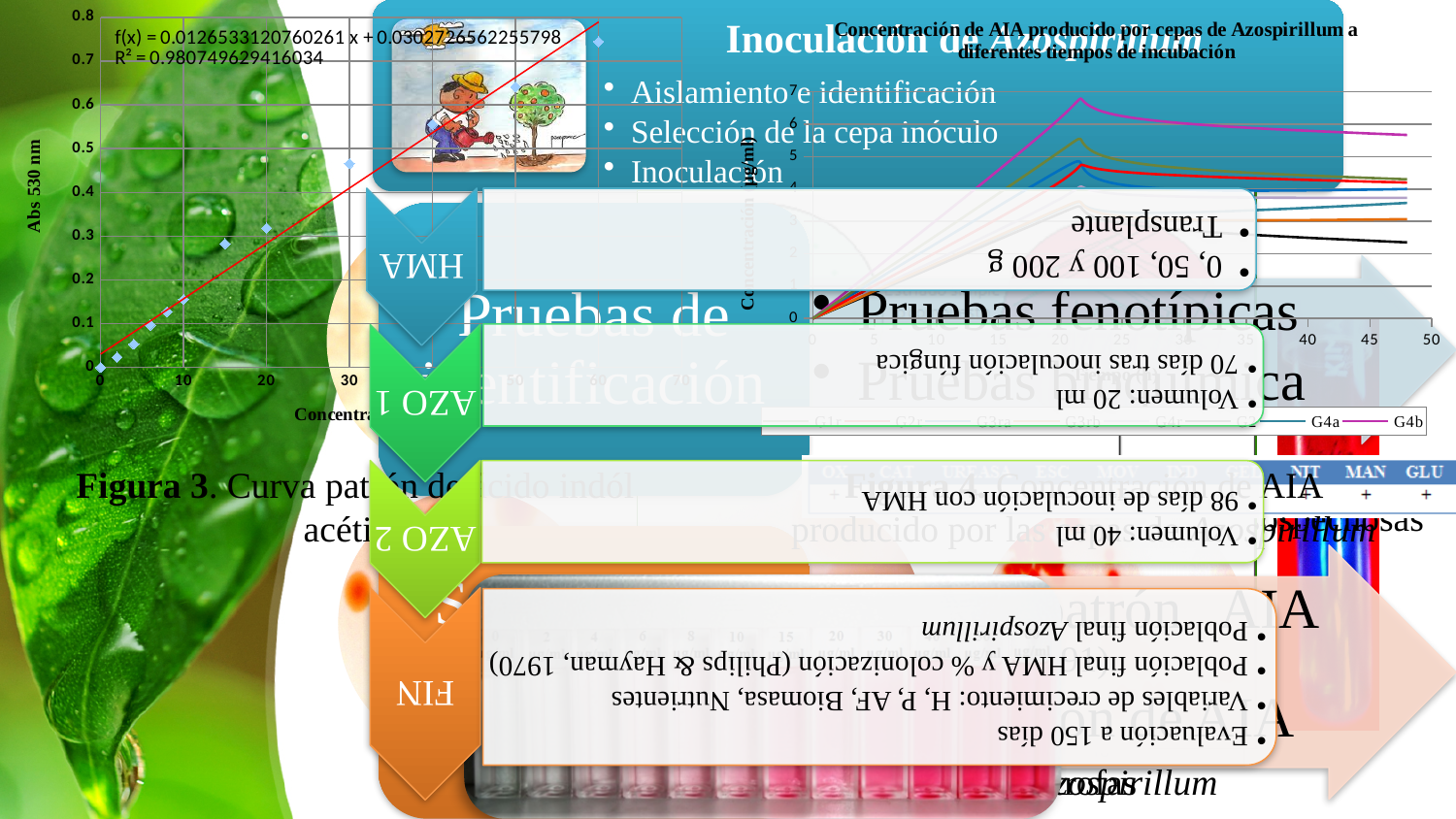
In the left chart (Figura 3), what is the highest value shown on the y axis? 0.8 In the left chart (Figura 3), what is the R² value shown for the trendline? R² = 0.980749629416034 What kind of chart is the chart on the left titled 'Figura 3. Curva patrón de ácido indól acético'? scatter chart What kind of chart is the chart titled 'Concentración de AIA producido por cepas de Azospirillum a diferentes tiempos de incubación'? line chart In the left chart (Figura 3), what is the slope of the trendline equation shown? 0.0126533120760261 In the chart 'Concentración de AIA producido por cepas de Azospirillum', what is the last series listed in the legend? G4b In the chart 'Concentración de AIA producido por cepas de Azospirillum', is the highest plotted value greater or less than 5? greater In the left chart (Figura 3), do the plotted values rise or fall as the x axis increases? rise In the chart 'Concentración de AIA producido por cepas de Azospirillum', what is the highest tick shown on the x axis? 50 In the left chart (Figura 3), what is the label of the y axis? Abs 530 nm